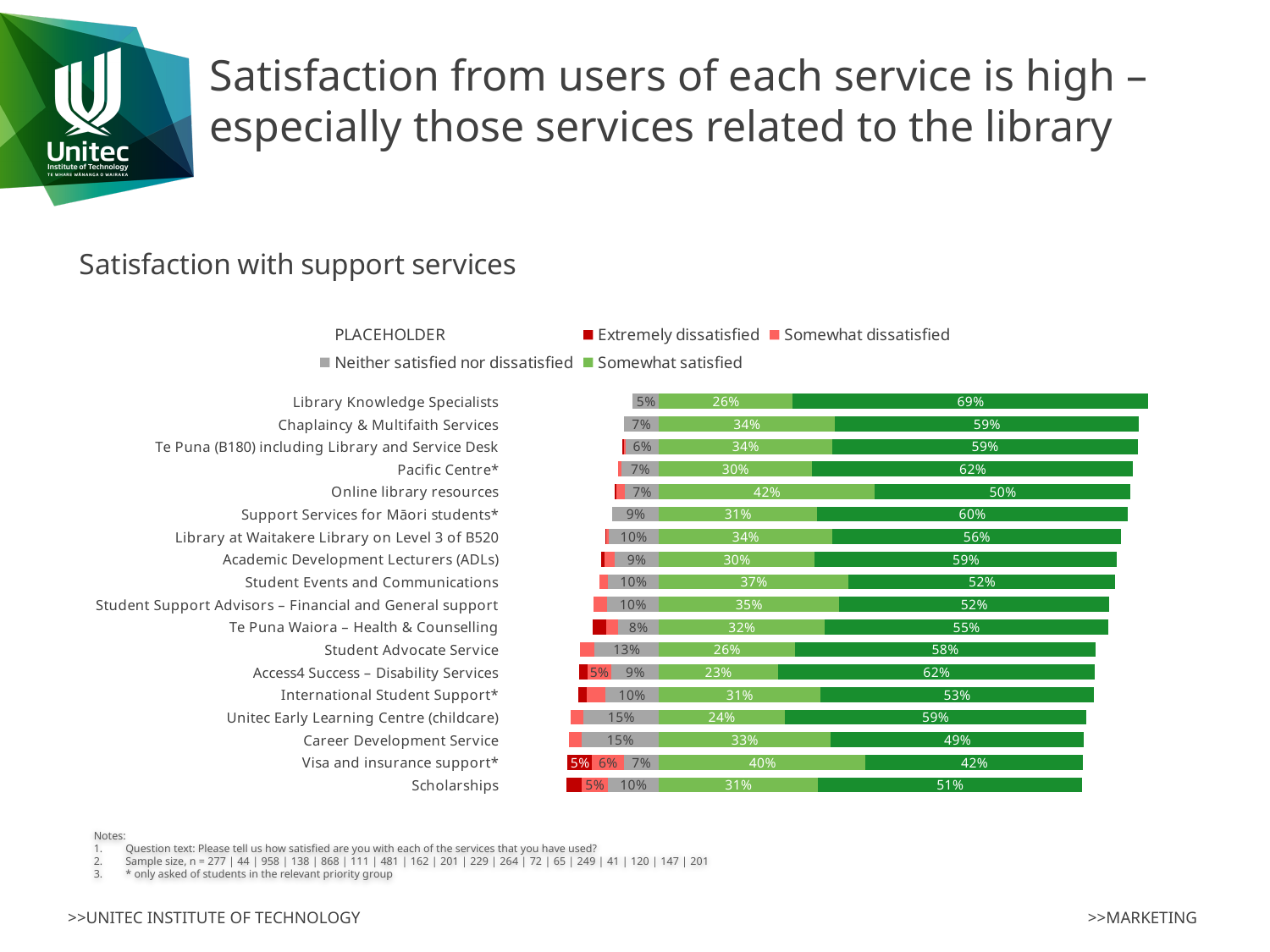
Which service has the lowest value in the dark green segment? Visa and insurance support* What is the 'Neither satisfied nor dissatisfied' value for Career Development Service? 15% Which has a larger 'Somewhat satisfied' value: Online library resources or Scholarships? Online library resources What is the title of the chart? Satisfaction with support services How many support services are listed as categories in the chart? 18 What kind of chart is shown on the slide? Stacked bar chart What is the 'Somewhat satisfied' value for Access4 Success – Disability Services? 23% What is the value of the dark green segment for Library Knowledge Specialists? 69% What is the difference between the dark green segment and the 'Somewhat satisfied' segment for Library Knowledge Specialists? 43 percentage points Which service has the highest 'Somewhat satisfied' value? Online library resources What is the 'Somewhat satisfied' value for Online library resources? 42% Which service has the highest value in the dark green segment? Library Knowledge Specialists